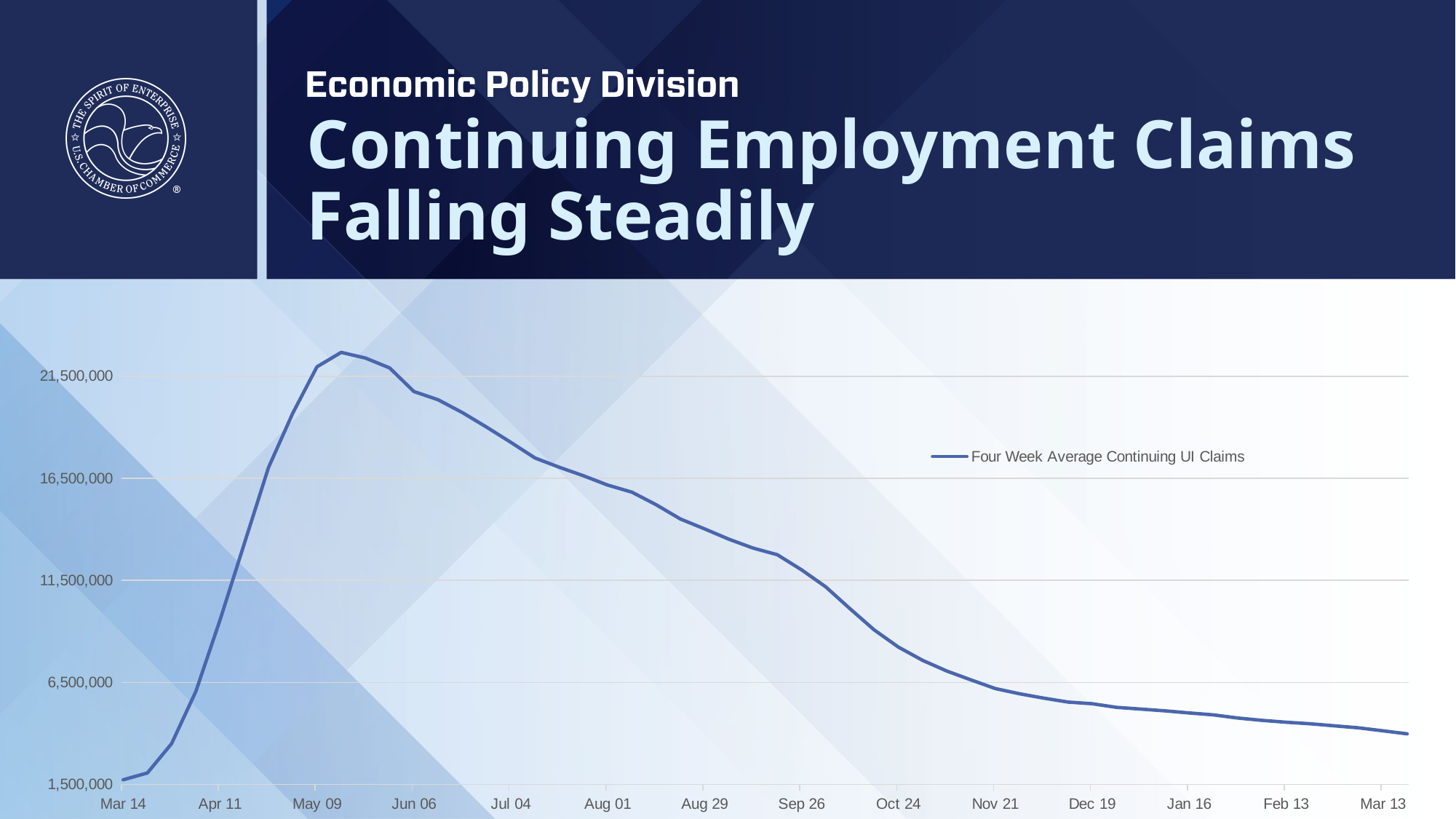
How many series does the legend list? 1 Is the value at Mar 13 greater or less than 6,500,000? less Is the value at Jul 04 greater or less than 16,500,000? greater Which x-axis date has the lowest value on the line? Mar 14 Is the value at Oct 24 greater or less than 6,500,000? greater Do the values rise or fall along the x axis from May 09 to Mar 13? fall What is the name of the series shown in the legend? Four Week Average Continuing UI Claims What kind of chart is shown on the slide? line chart Around which x-axis date does the line reach its highest value? May 09 Which is larger, the value at Jul 04 or the value at Oct 24? Jul 04